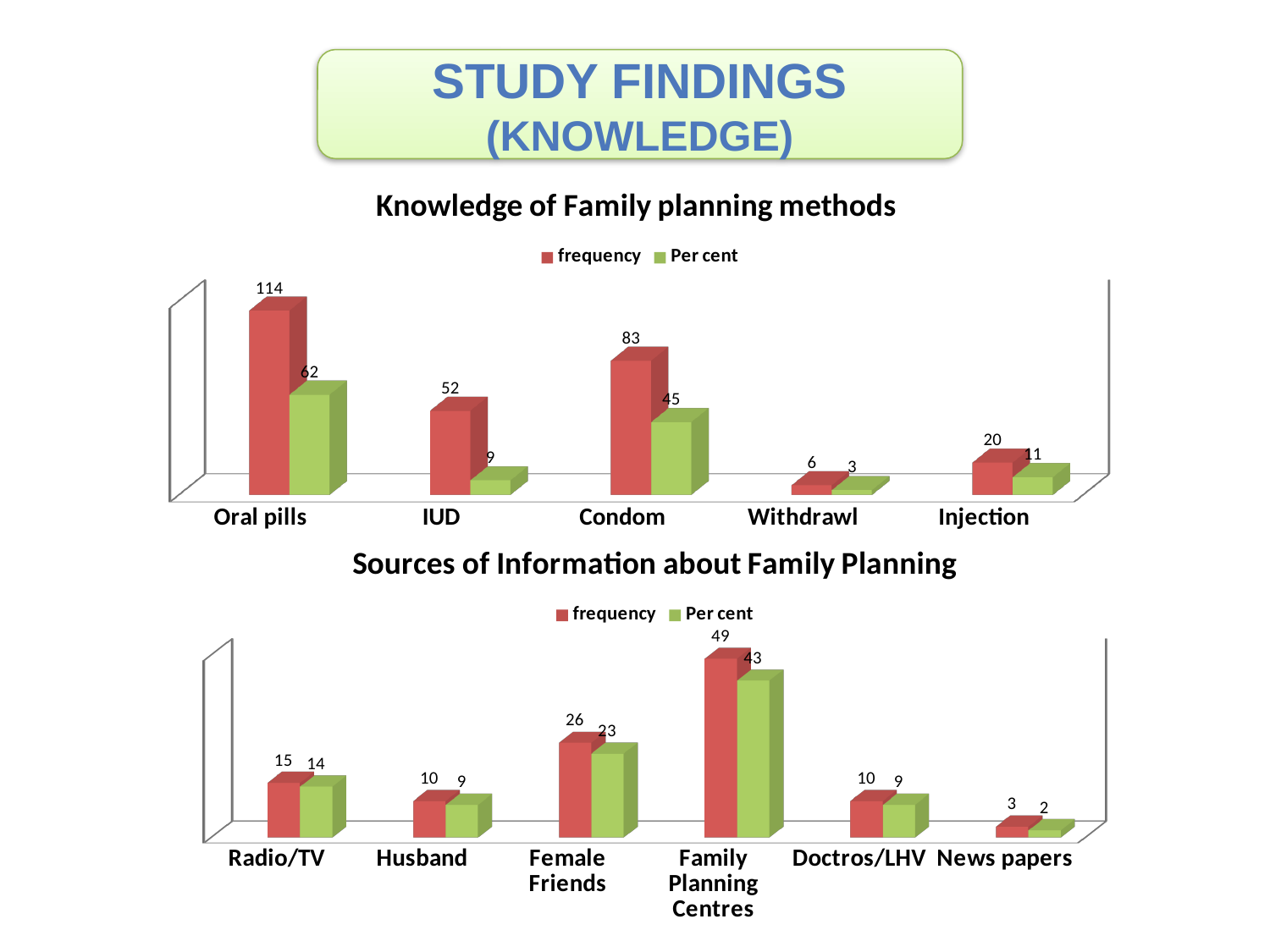
In the 'Sources of Information about Family Planning' chart, what is the Per cent value for News papers? 2 In the 'Knowledge of Family planning methods' chart, what is the difference between the frequency for Oral pills and the frequency for Condom? 31 What kind of chart is the 'Knowledge of Family planning methods' chart? Bar chart In the 'Sources of Information about Family Planning' chart, what is the difference between the frequency for Female Friends and the frequency for Radio/TV? 11 In the 'Knowledge of Family planning methods' chart, what is the Per cent value for Condom? 45 In the 'Knowledge of Family planning methods' chart, how many family planning methods are shown on the x axis? 5 In the 'Knowledge of Family planning methods' chart, which method has the lowest frequency? Withdrawl In the 'Sources of Information about Family Planning' chart, what is the frequency for Family Planning Centres? 49 In the 'Sources of Information about Family Planning' chart, which source has the highest Per cent value? Family Planning Centres How many series does the legend of the 'Sources of Information about Family Planning' chart list? 2 In the 'Knowledge of Family planning methods' chart, which is larger: the frequency for IUD or the frequency for Injection? IUD In the 'Knowledge of Family planning methods' chart, what is the frequency for Oral pills? 114